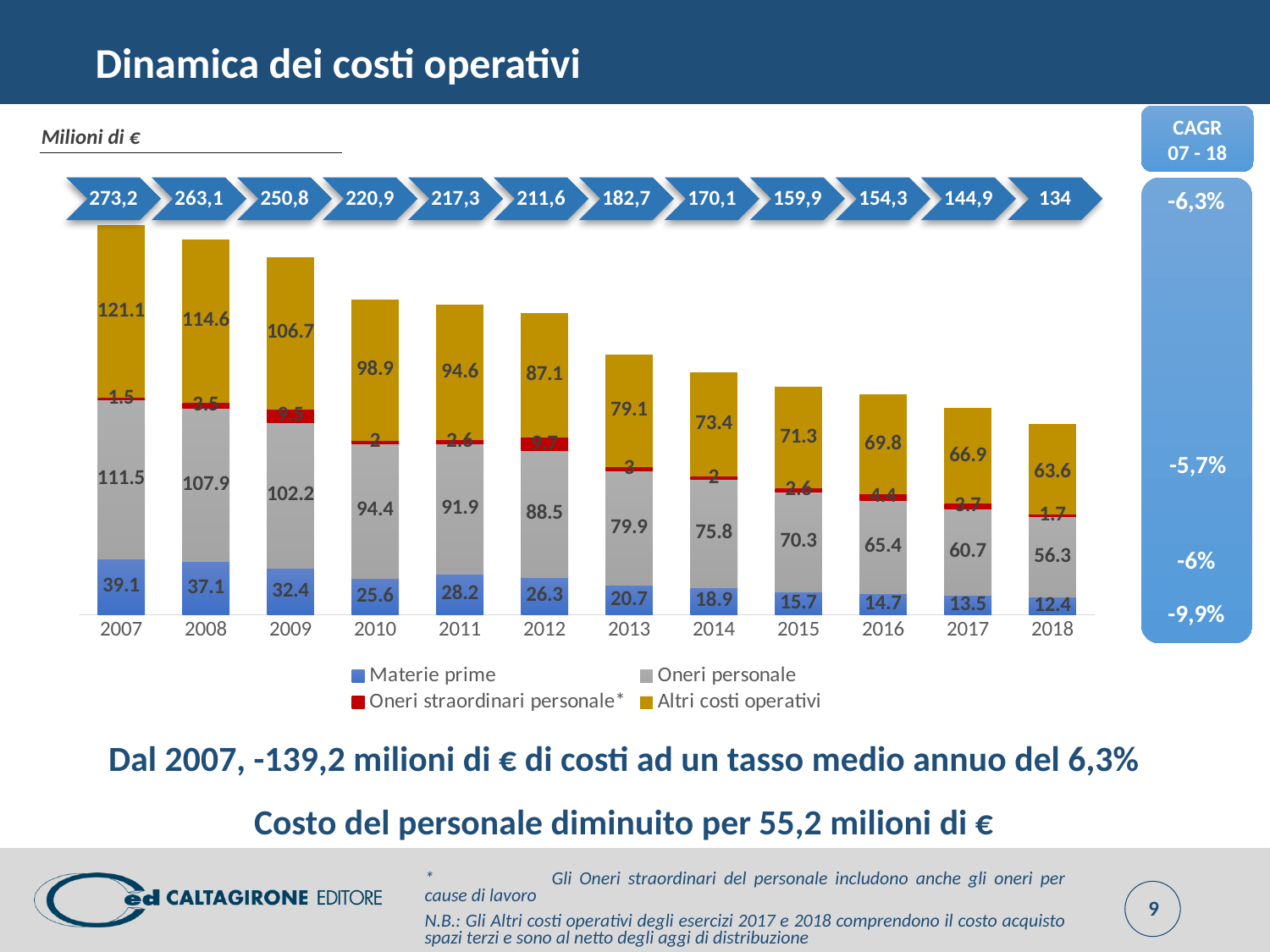
How many years are shown on the x axis of the chart? 12 What is the difference between Oneri personale in 2007 and in 2018? 55.2 What is the value of Oneri personale in 2018? 56.3 What is the value of Altri costi operativi in 2007? 121.1 What kind of chart is shown on the slide? Stacked bar chart What is the value of Materie prime in 2011? 28.2 In which year is Altri costi operativi lowest? 2018 How many series does the chart legend list? 4 In which year is Materie prime highest? 2007 Do the total operating costs rise or fall from 2007 to 2018? Fall What is the total of the stacked bar for 2007? 273,2 Which year has the larger value for Materie prime, 2010 or 2011? 2011